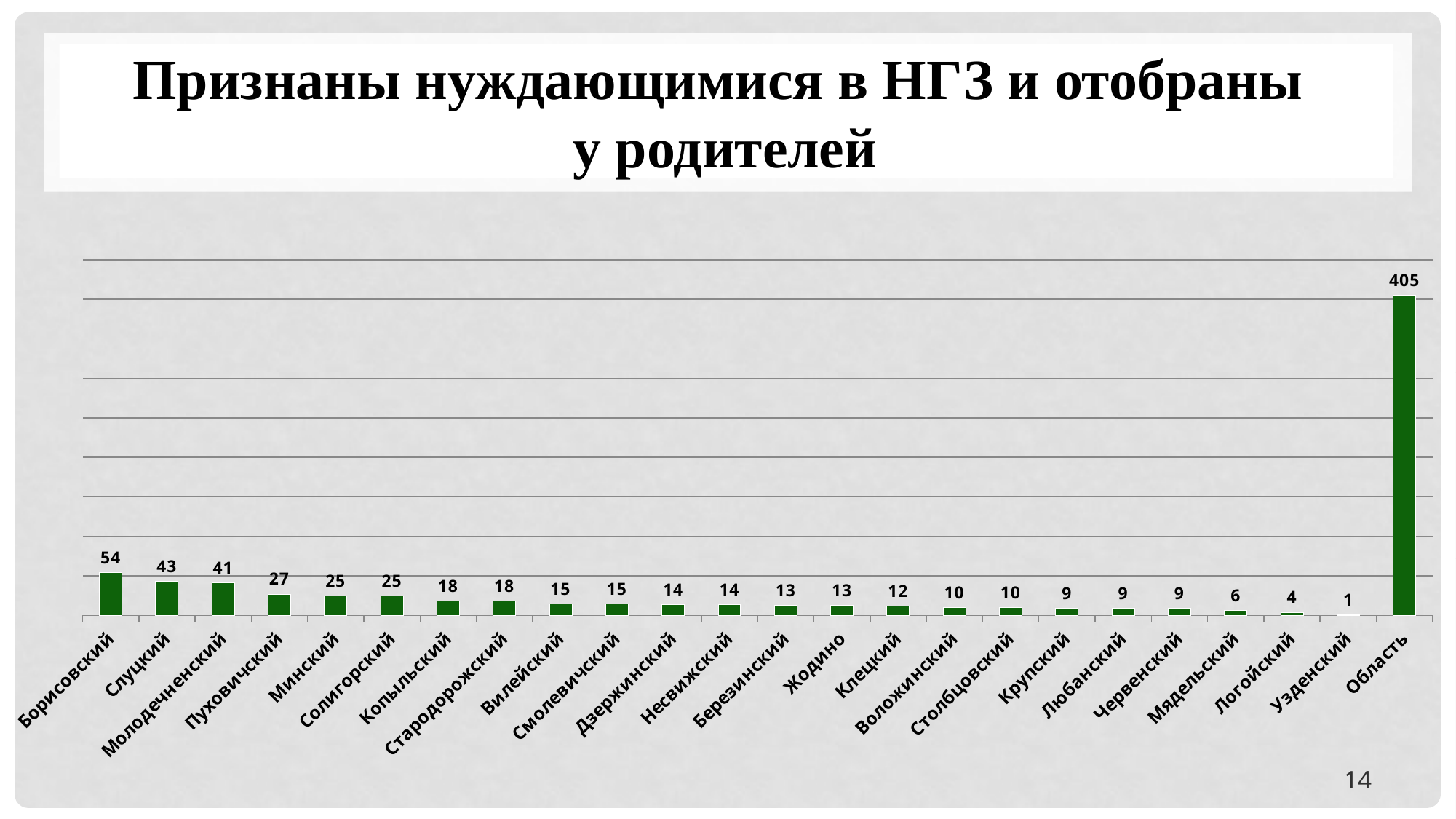
What is the value for Борисовский? 54 What is the value for Область? 405 What kind of chart is shown on the slide? Bar chart What colour are the bars in the chart? Green How many categories are shown on the x axis? 24 Which category has the lowest value? Узденский What is the difference between the values for Борисовский and Пуховичский? 27 Which is larger, the value for Клецкий or the value for Воложинский? Клецкий What is the value for Жодино? 13 Which category has the highest value? Область What is the difference between the values for Слуцкий and Молодечненский? 2 What is the value for Мядельский? 6